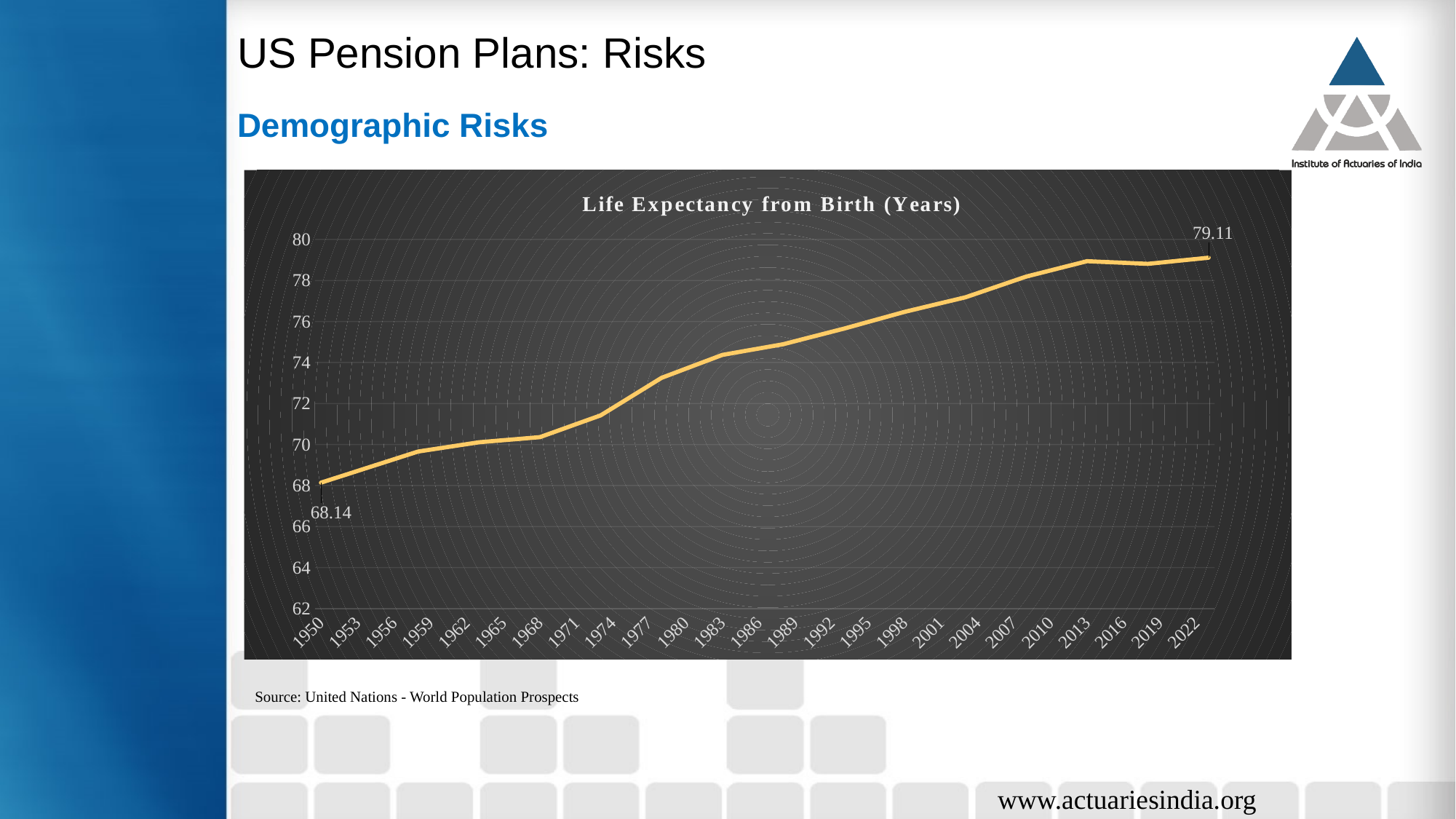
Which year has the lowest life expectancy on the chart? 1950 What kind of chart is shown on the slide? line chart Is the life expectancy value for 1980 greater or less than 72? greater How many year labels are shown on the x axis? 25 Is the life expectancy value for 2013 greater or less than 78? greater Does life expectancy generally rise or fall from 1950 to 2022? rise What is the life expectancy value shown for 1950? 68.14 Is the life expectancy value for 1971 greater or less than 72? less What is the title of the chart? Life Expectancy from Birth (Years)